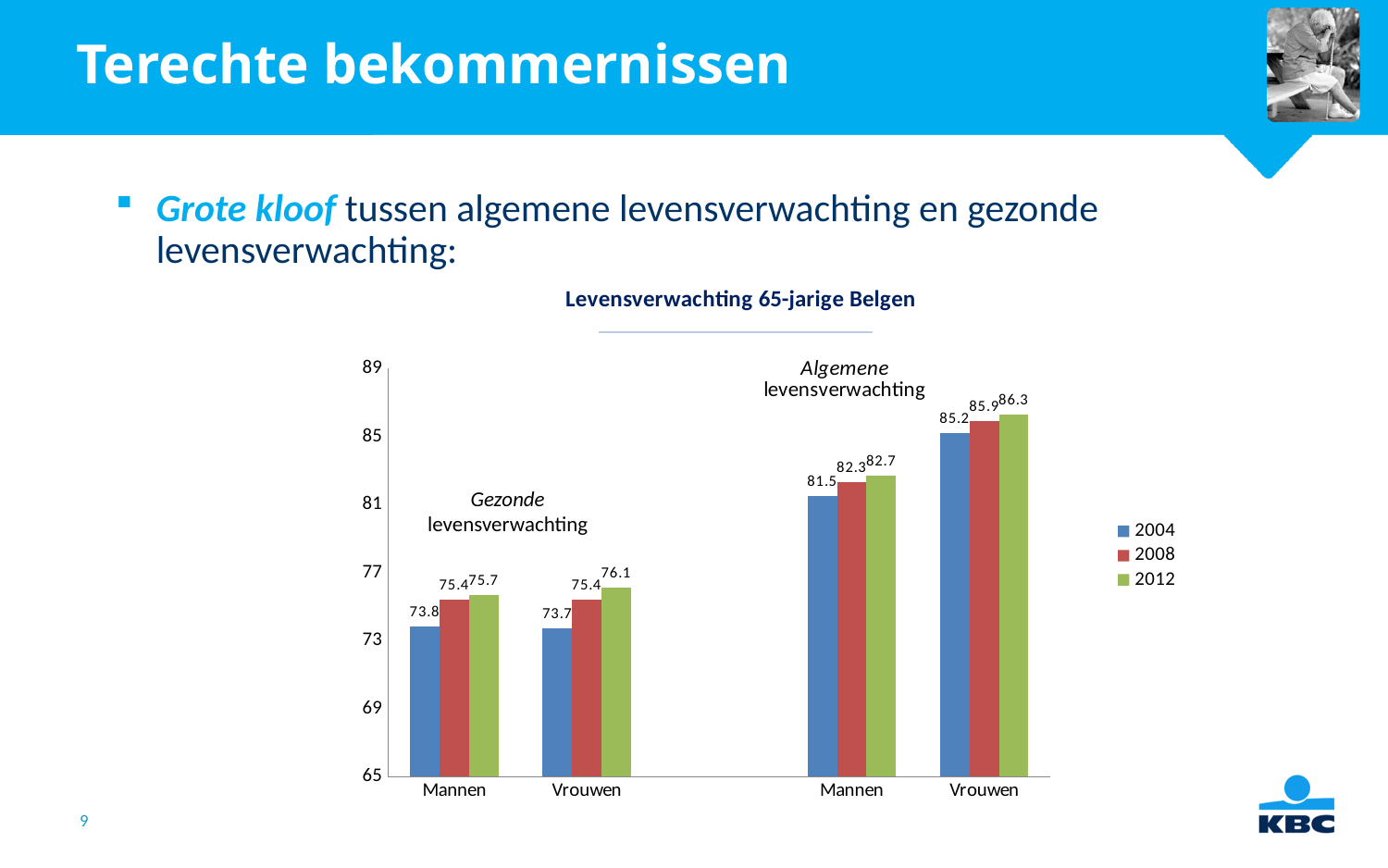
How many series does the chart legend list? 3 Which bar in the chart has the highest value? 2012, Vrouwen (Algemene levensverwachting) Which is larger: the 2004 value for Mannen or for Vrouwen under Algemene levensverwachting? Vrouwen What is the 2012 value for Vrouwen under Algemene levensverwachting? 86.3 What is the 2008 value for Mannen under Algemene levensverwachting? 82.3 Do the values for Vrouwen under Algemene levensverwachting rise or fall from 2004 to 2012? rise Is the 2004 value for Mannen under Algemene levensverwachting greater or less than 81? greater What is the 2012 value for Vrouwen under Gezonde levensverwachting? 76.1 What is the difference between the 2012 values for Vrouwen under Algemene levensverwachting and Gezonde levensverwachting? 10.2 What is the title of the chart? Levensverwachting 65-jarige Belgen What is the 2004 value for Mannen under Gezonde levensverwachting? 73.8 What kind of chart is shown on the slide? bar chart